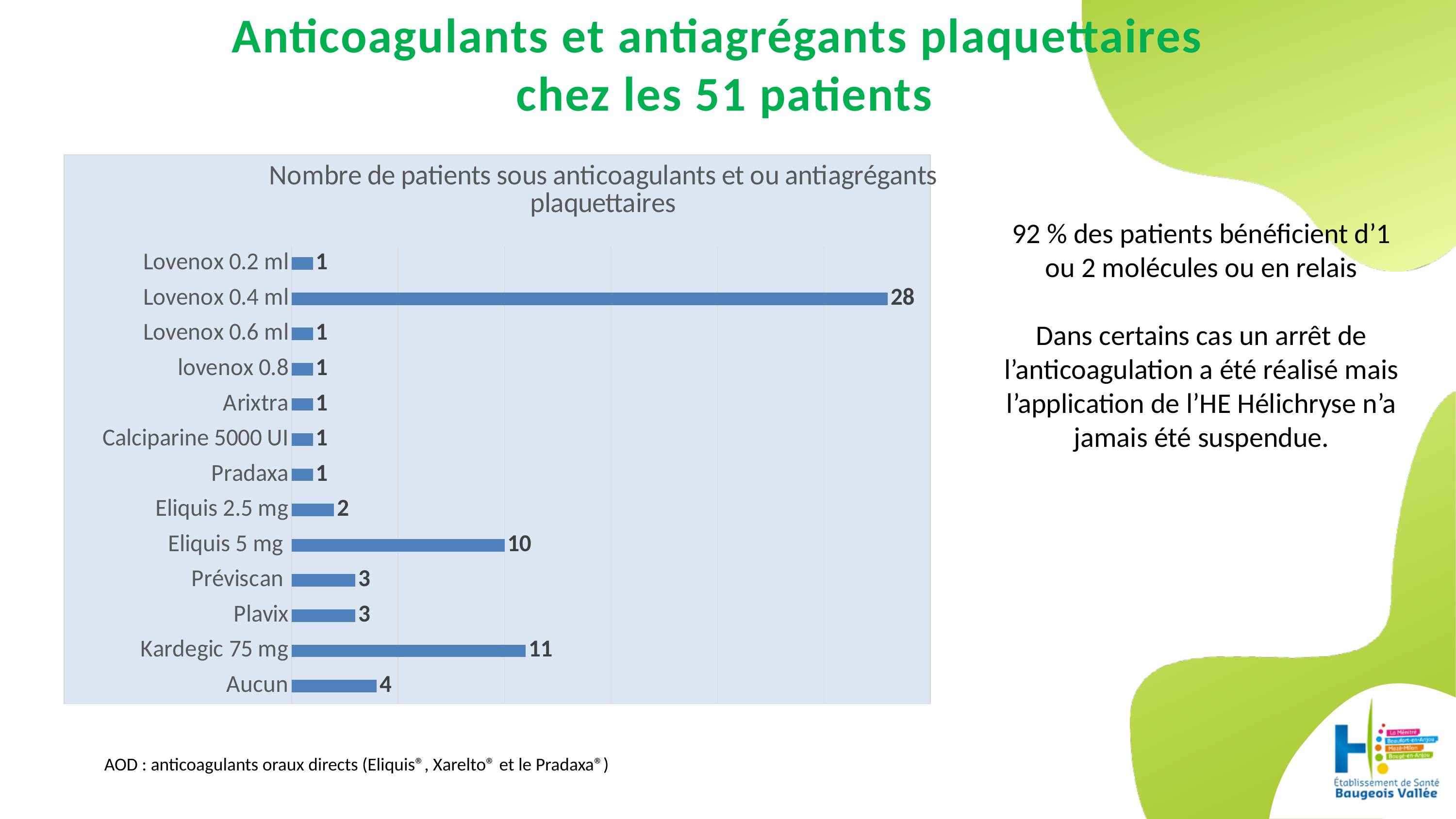
Which category has the highest value? Lovenox 0.4 ml What is the value for Lovenox 0.4 ml? 28 What is the difference between the values for Eliquis 5 mg and Eliquis 2.5 mg? 8 How many categories are shown in the chart? 13 Which is larger, the value for Aucun or the value for Plavix? Aucun What is the value for Eliquis 5 mg? 10 What is the difference between the values for Lovenox 0.4 ml and Kardegic 75 mg? 17 What is the value for Kardegic 75 mg? 11 What is the value for Aucun? 4 Which is larger, the value for Kardegic 75 mg or the value for Eliquis 5 mg? Kardegic 75 mg What is the title of the chart? Nombre de patients sous anticoagulants et ou antiagrégants plaquettaires What kind of chart is shown on the slide? Bar chart